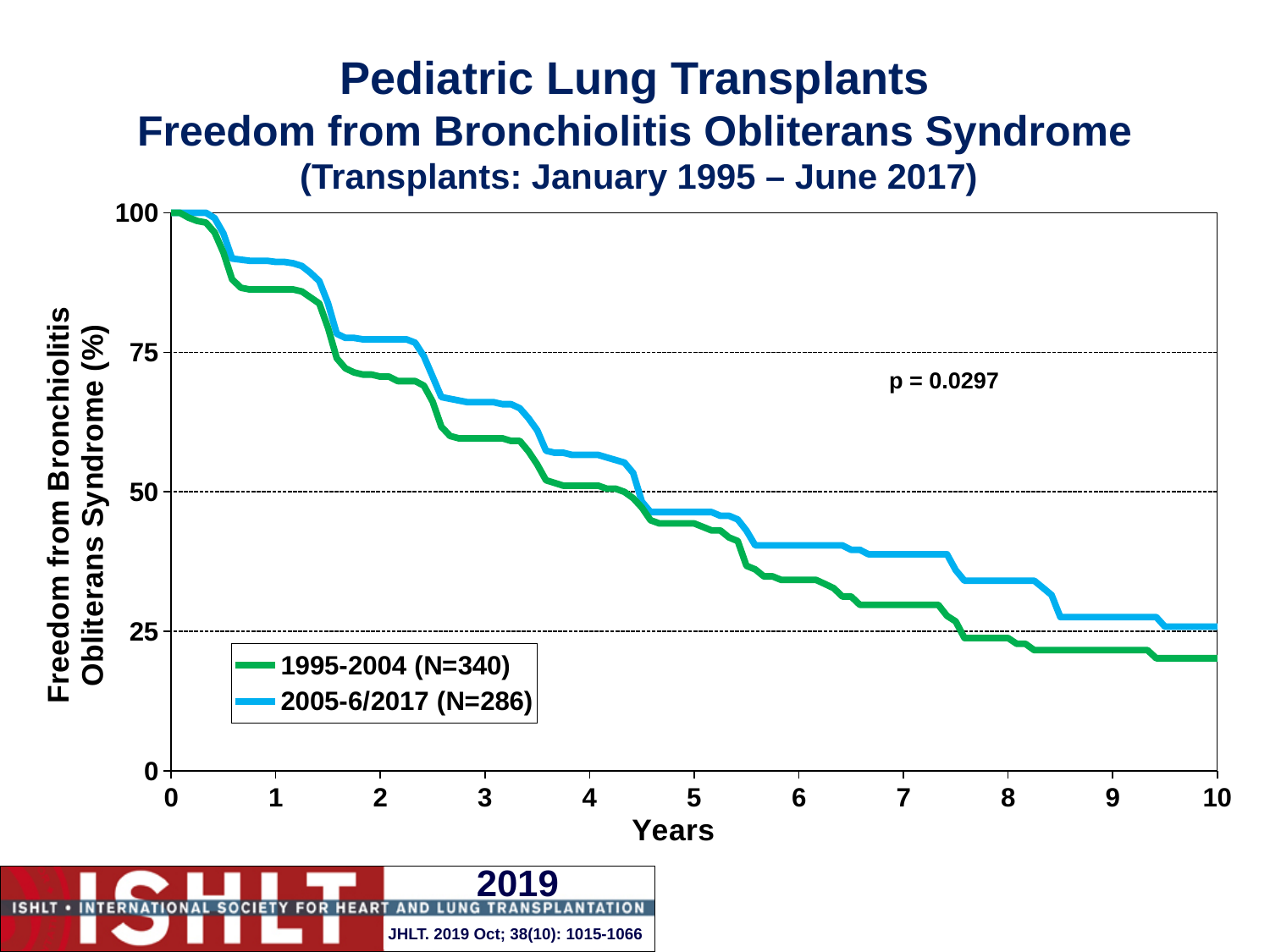
Is the value for the 2005-6/2017 (N=286) series at year 2 greater or less than 75? greater What is the freedom from bronchiolitis obliterans syndrome for both series at year 0? 100 Is the value for the 1995-2004 (N=340) series at year 10 greater or less than 25? less At year 7, which series has the higher freedom from bronchiolitis obliterans syndrome? 2005-6/2017 (N=286) Is the value for the 2005-6/2017 (N=286) series at year 8 greater or less than 25? greater What kind of chart is shown on the slide? line chart What is the N for the 1995-2004 series in the legend? 340 How many series does the legend list? 2 What p-value is shown on the chart? p = 0.0297 Do the values for the 1995-2004 series rise or fall as years increase? fall